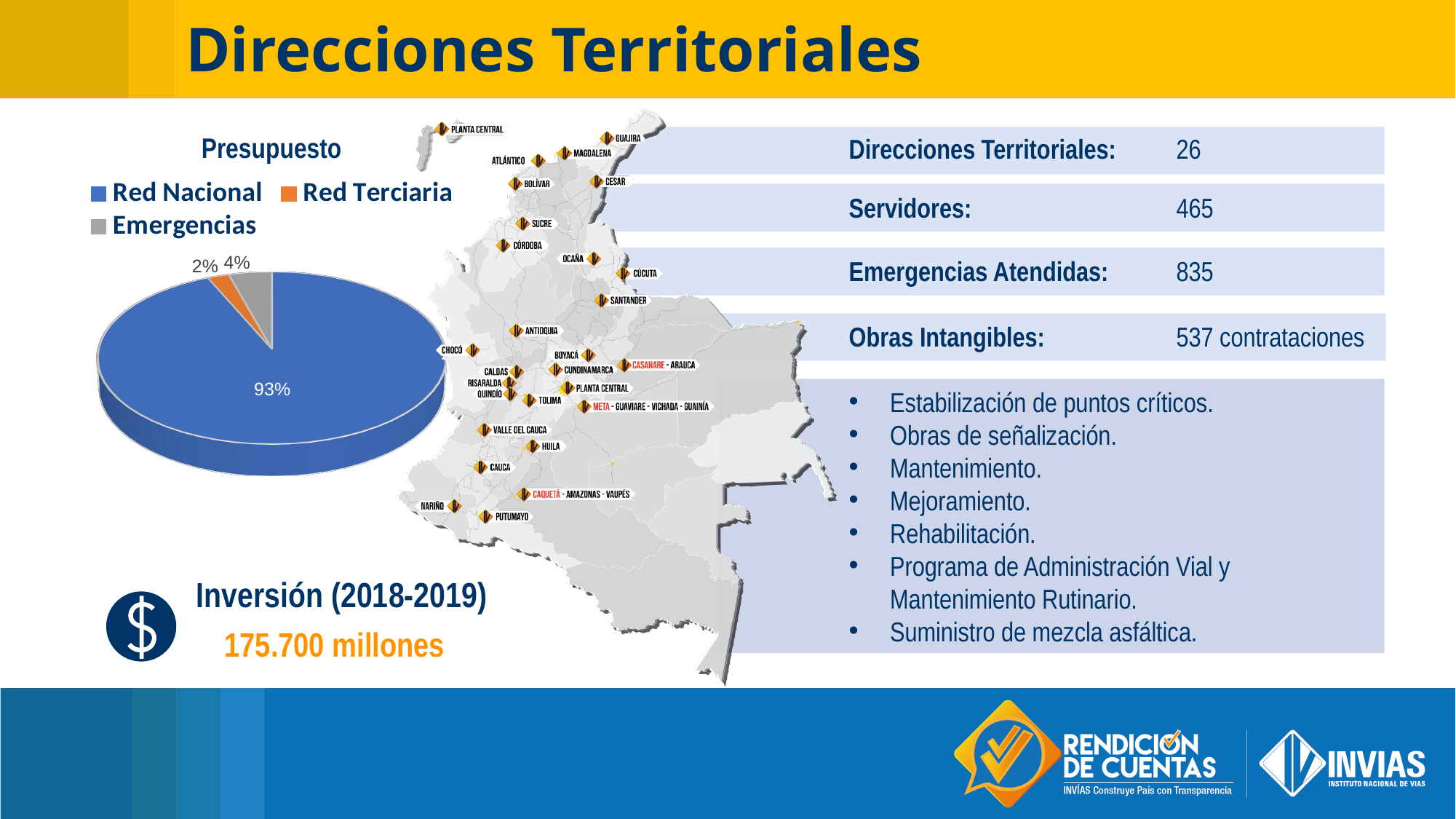
What share of the Presupuesto pie chart is Emergencias? 4% In the Presupuesto pie chart, which is larger, Emergencias or Red Terciaria? Emergencias What colour is the Red Nacional slice in the Presupuesto pie chart? blue What kind of chart is shown under the title "Presupuesto"? pie chart How many categories does the legend of the Presupuesto pie chart list? 3 Which category has the largest slice in the Presupuesto pie chart? Red Nacional In the Presupuesto pie chart, what is the difference in percentage points between Red Nacional and Emergencias? 89 What share of the Presupuesto pie chart is Red Terciaria? 2% Which category has the smallest slice in the Presupuesto pie chart? Red Terciaria In the Presupuesto pie chart, what is the difference in percentage points between Emergencias and Red Terciaria? 2 What share of the Presupuesto pie chart is Red Nacional? 93% What is the title of the pie chart? Presupuesto